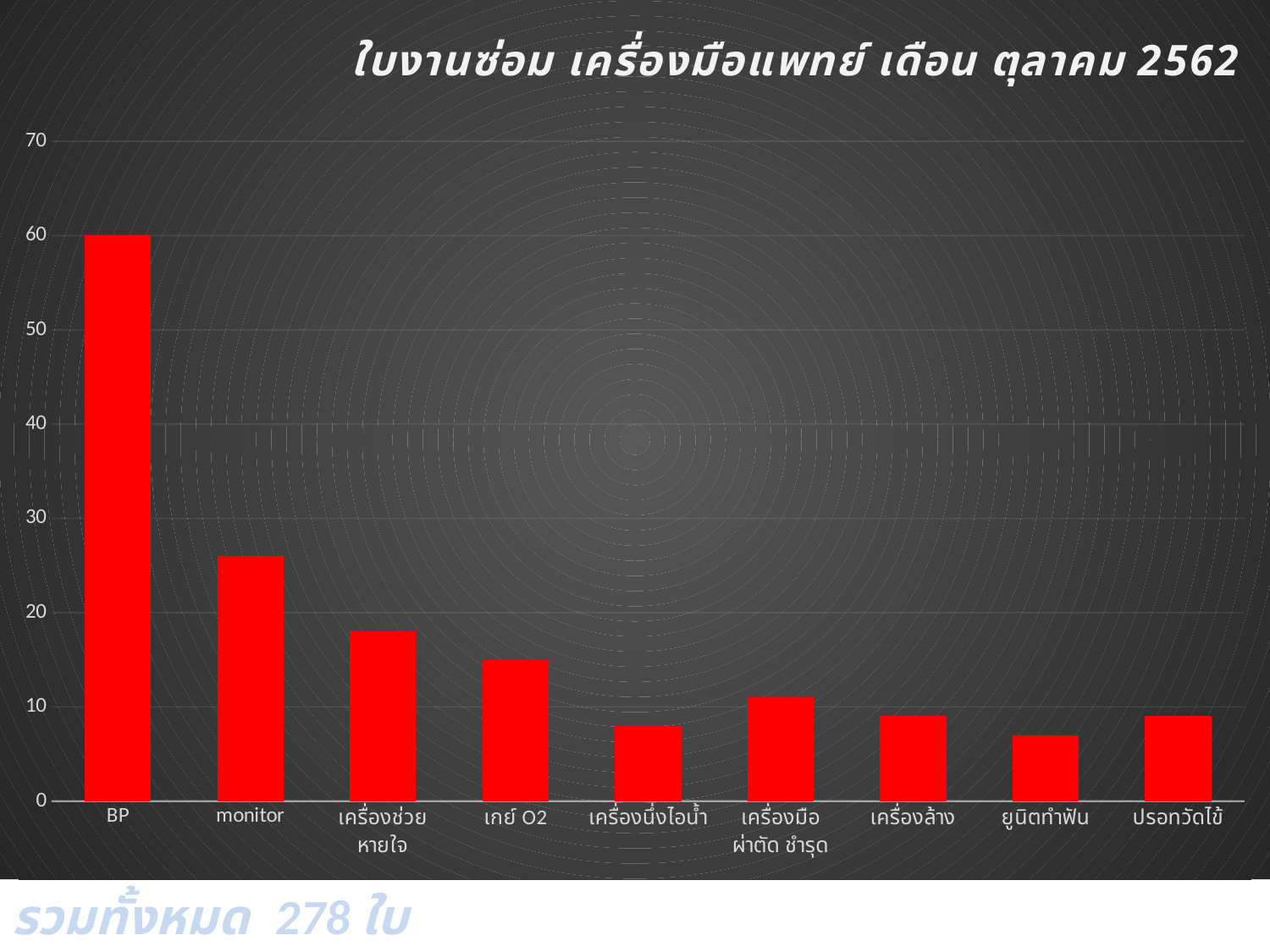
Which is larger, the value for monitor or the value for เครื่องช่วยหายใจ? monitor Is the value for monitor greater or less than 20? greater What is the title of the chart? ใบงานซ่อม เครื่องมือแพทย์ เดือน ตุลาคม 2562 Which is larger, the value for เครื่องช่วยหายใจ or the value for เครื่องนึ่งไอน้ำ? เครื่องช่วยหายใจ What type of chart is shown on the slide? bar chart Is the value for ยูนิตทำฟัน greater or less than 10? less Is the value for เกย์ O2 greater or less than 20? less How many categories are shown on the x axis of the chart? 9 Which category has the highest value in the chart? BP What is the value for BP? 60 What total number of repair orders is stated in the text at the bottom of the slide? 278 ใบ